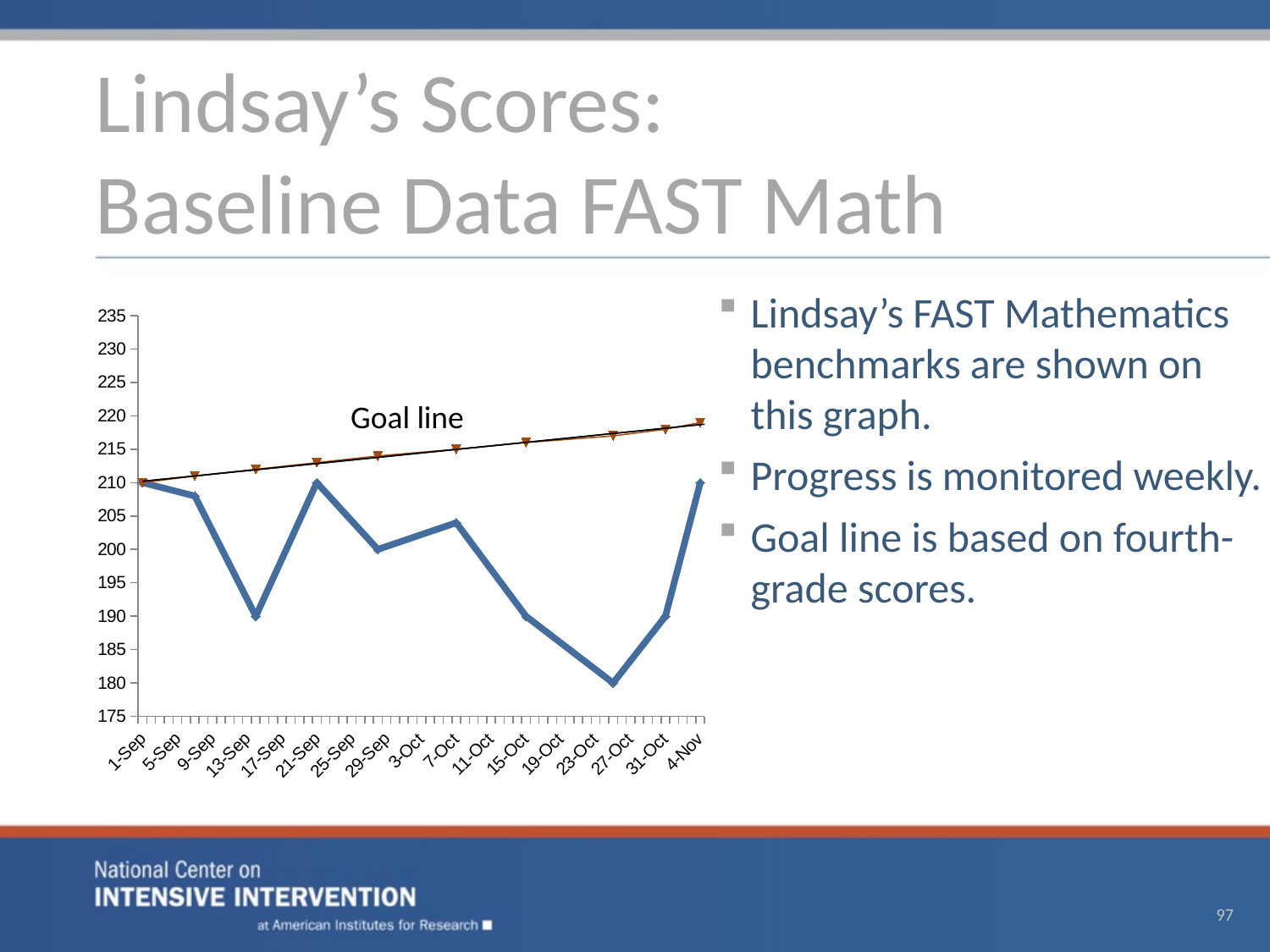
Does the goal line rise or fall from 1-Sep to 4-Nov? rises Is the first point of the blue score line at 1-Sep greater or less than 205? greater What text label is printed next to the upper line on the chart? Goal line What are the minimum and maximum values shown on the y axis? 175 and 235 What is the lowest value reached by the blue score line? 180 At 4-Nov, which is higher: the goal line or the blue score line? the goal line What is the highest value reached by the blue score line? 210 Is the value of the goal line at 4-Nov greater or less than 215? greater How many date labels are shown on the x axis? 17 What is the value of the goal line at 1-Sep? 210 Is the lowest point of the blue score line greater or less than 185? less What kind of chart is shown on the slide? line chart